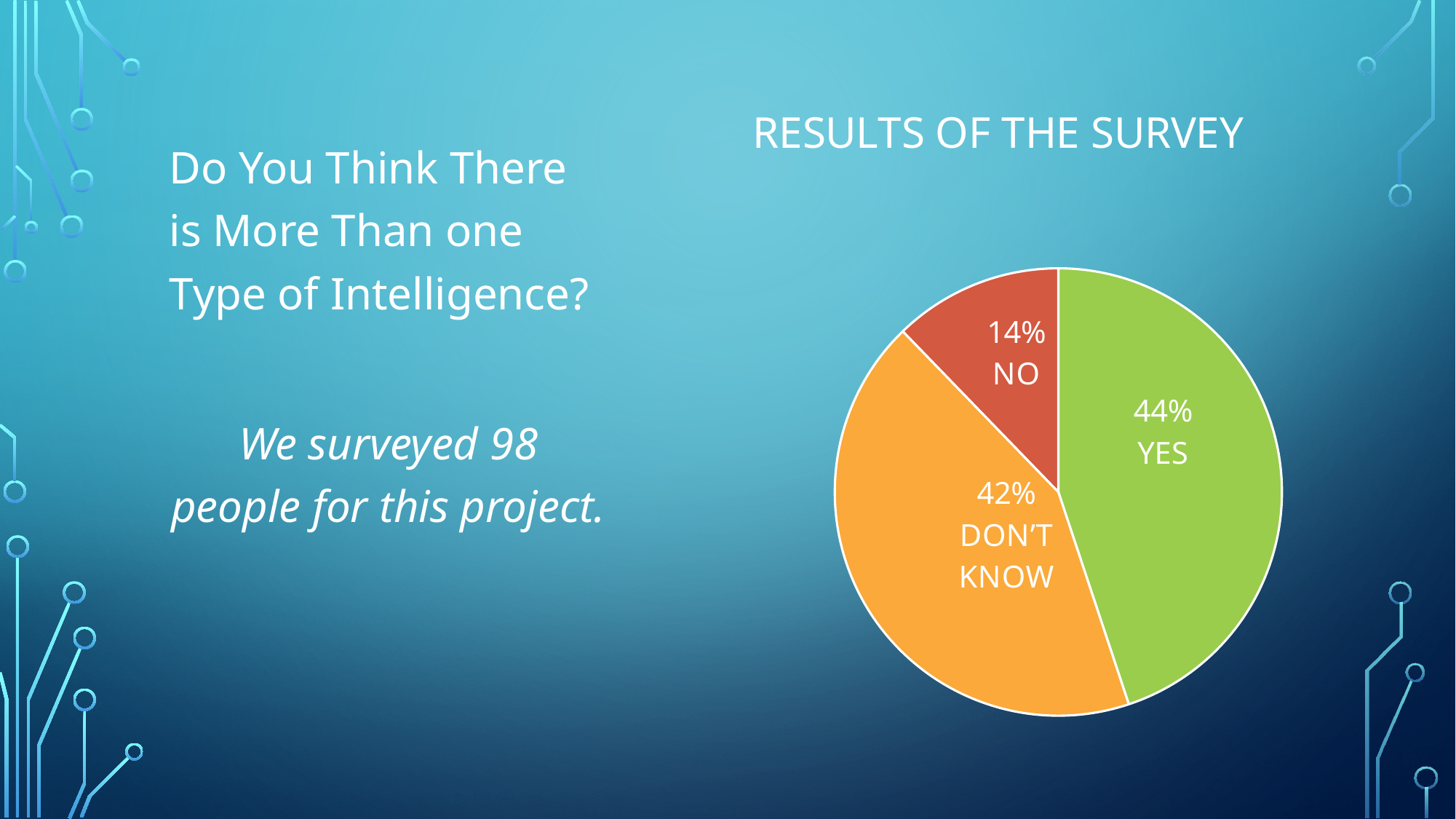
What is the title of the chart? RESULTS OF THE SURVEY Which response has the largest share of the pie? YES Which response has the smallest share of the pie? NO What percentage of respondents answered NO? 14% What kind of chart is shown on the slide? Pie chart How many slices does the pie chart have? 3 What percentage of respondents answered YES? 44% Which slice is larger, DON'T KNOW or NO? DON'T KNOW What is the difference in percentage points between the YES and NO slices? 30 What percentage of respondents answered DON'T KNOW? 42% What colour is the YES slice? Green What is the difference in percentage points between the DON'T KNOW and NO slices? 28